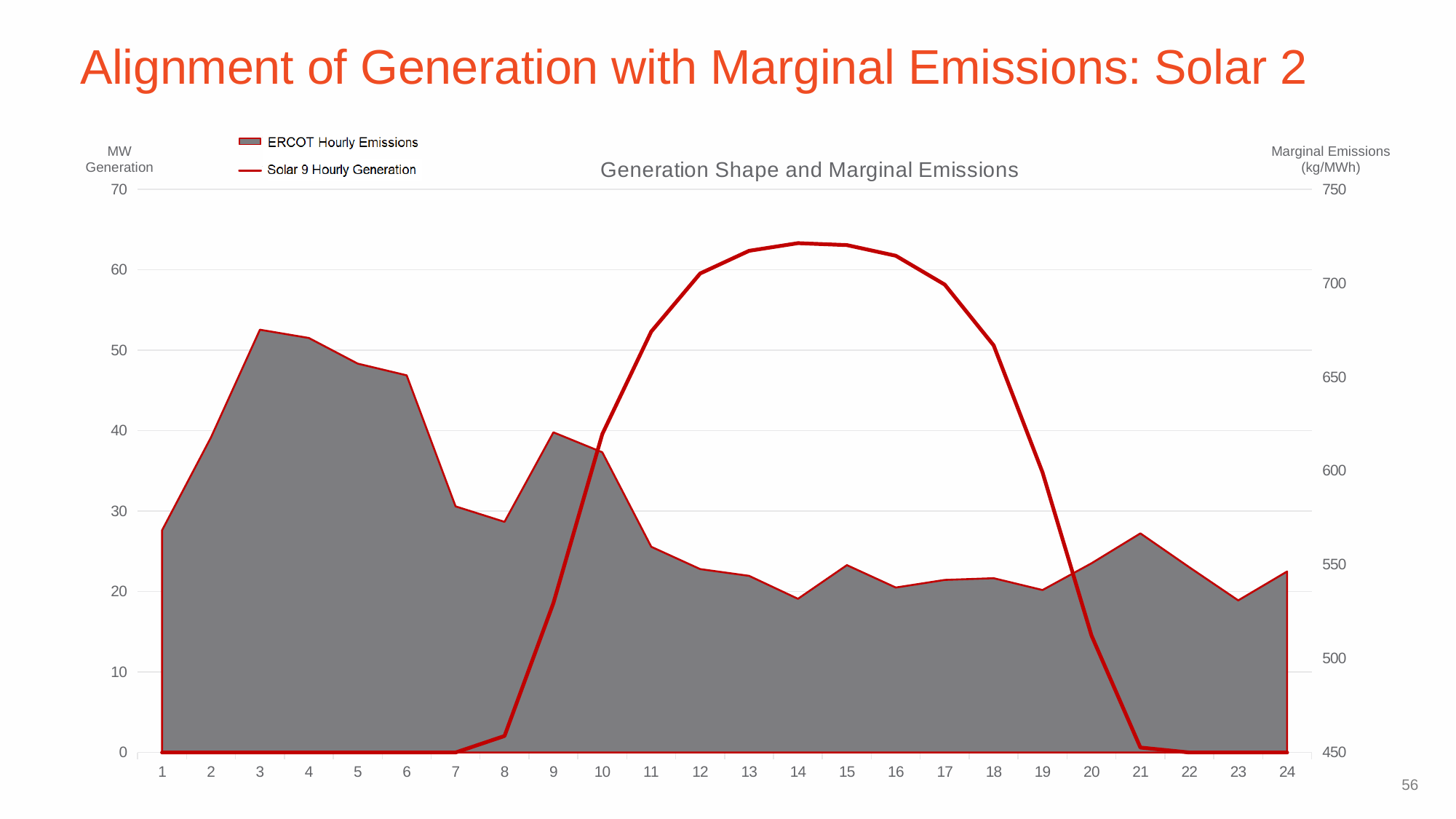
Is the ERCOT Hourly Emissions value at hour 3 greater or less than 650 kg/MWh? greater Is the Solar 9 Hourly Generation value at hour 9 greater or less than 30 MW? less How many hours are plotted along the x axis? 24 Is the Solar 9 Hourly Generation value at hour 14 greater or less than 60 MW? greater Which series is drawn as a red line? Solar 9 Hourly Generation Does the Solar 9 Hourly Generation line rise or fall from hour 14 to hour 21? fall What is the title of the chart? Generation Shape and Marginal Emissions How many series does the chart legend list? 2 Does the ERCOT Hourly Emissions series rise or fall from hour 3 to hour 8? fall